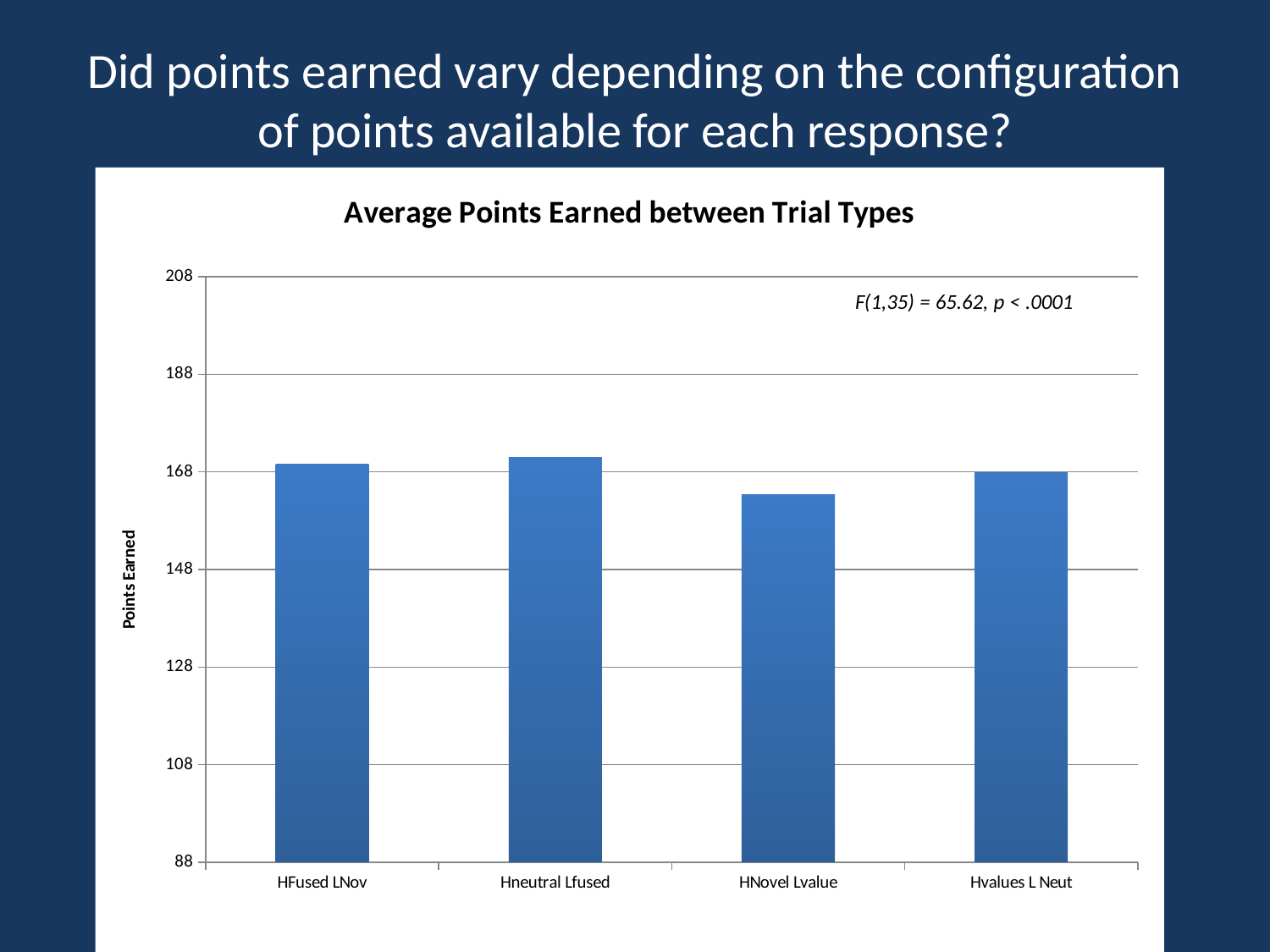
What is the label of the vertical axis? Points Earned Which is larger, the value for Hneutral Lfused or the value for HNovel Lvalue? Hneutral Lfused What kind of chart is shown on the slide? bar chart How many trial types (categories) are shown on the x axis of the chart? 4 Which is larger, the value for HFused LNov or the value for HNovel Lvalue? HFused LNov Is the value for HNovel Lvalue greater or less than 168? less What is the title of the chart? Average Points Earned between Trial Types Is the value for HFused LNov greater or less than 168? greater Is the value for Hneutral Lfused greater or less than 188? less Which trial type has the lowest average points earned? HNovel Lvalue